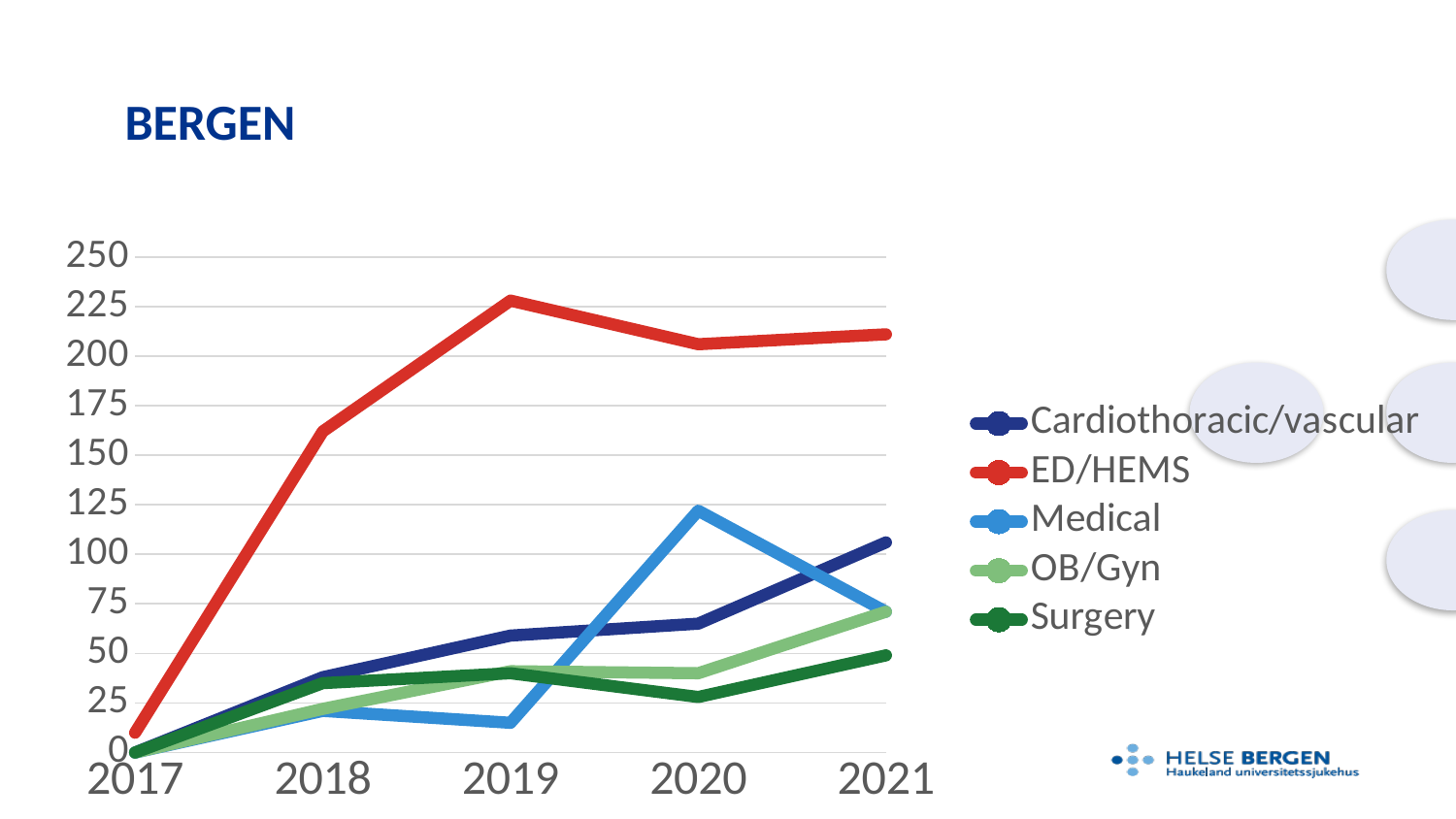
What is the title of the slide? BERGEN In which year does ED/HEMS reach its highest value? 2019 Which series has the highest value in 2021? ED/HEMS Does the Cardiothoracic/vascular line rise or fall from 2017 to 2021? rise How many series does the legend list? 5 In 2020, which is larger: Medical or Cardiothoracic/vascular? Medical Which series has the lowest value in 2021? Surgery Is the value for ED/HEMS in 2019 greater or less than 200? greater What kind of chart is shown on the slide? line chart Is the value for Medical in 2020 greater or less than 100? greater How many years are shown on the x axis? 5 Is the value for Surgery in 2020 greater or less than 50? less